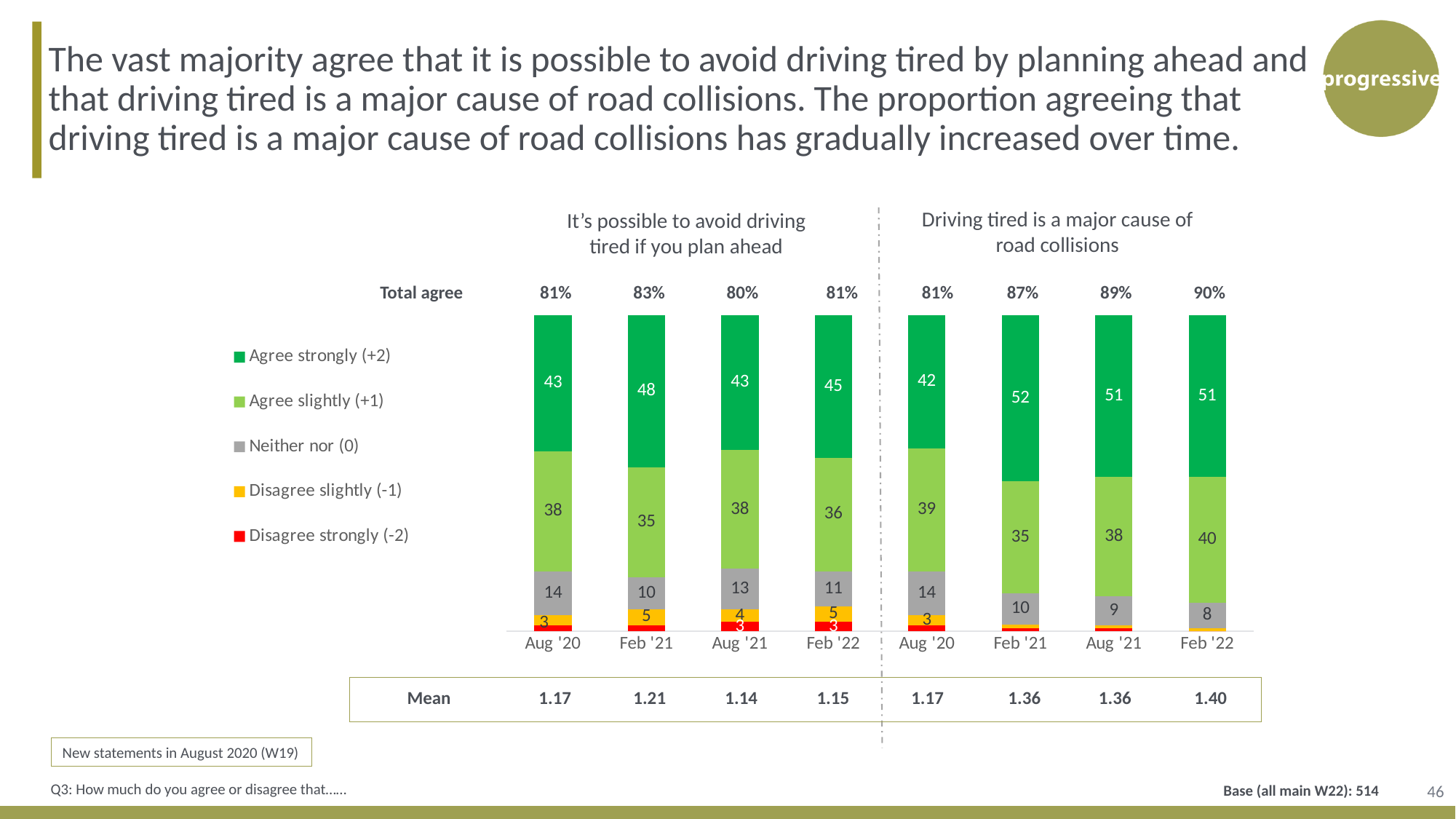
In the 'Driving tired is a major cause of road collisions' chart, what is the difference between the Total agree for Feb '22 and Aug '20? 9 percentage points In the 'Driving tired is a major cause of road collisions' chart, does the Total agree percentage rise or fall from Aug '20 to Feb '22? Rise What is the Mean value for Feb '22 in the 'Driving tired is a major cause of road collisions' chart? 1.40 In the 'It's possible to avoid driving tired if you plan ahead' chart, which is larger: the 'Agree strongly (+2)' value for Feb '21 or for Aug '21? Feb '21 In the 'It's possible to avoid driving tired if you plan ahead' chart, what is the 'Agree slightly (+1)' value for Feb '21? 35 Which colour represents 'Disagree strongly (-2)' in the legend? Red What type of chart is shown on the slide? Stacked bar chart In the 'Driving tired is a major cause of road collisions' chart, what is the 'Agree strongly (+2)' value for Feb '21? 52 In the 'Driving tired is a major cause of road collisions' chart, which wave has the highest Total agree percentage? Feb '22 How many series does the legend list? 5 How many waves (bars) are shown in the 'Driving tired is a major cause of road collisions' chart? 4 In the 'It's possible to avoid driving tired if you plan ahead' chart, which wave has the lowest Total agree percentage? Aug '21